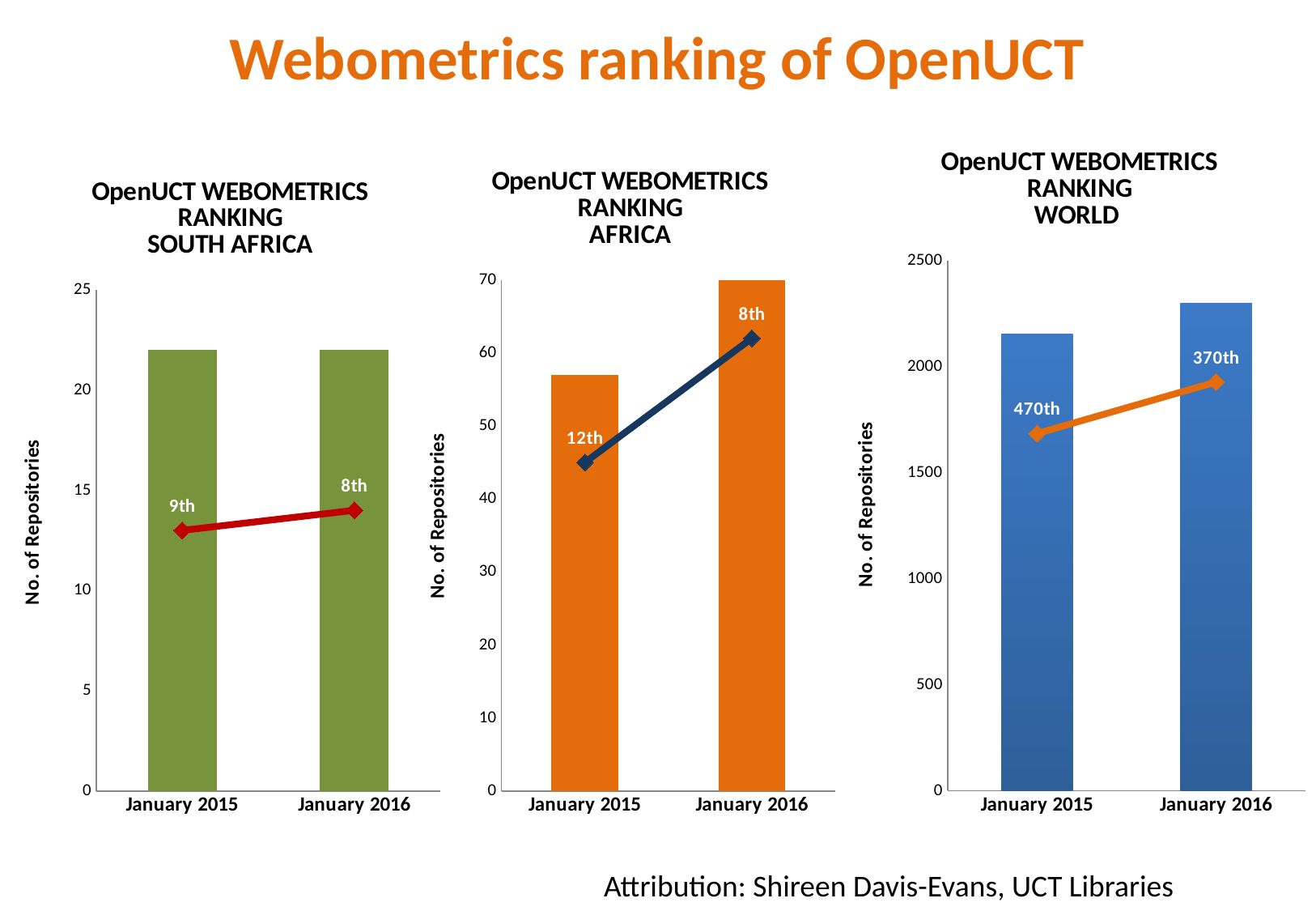
On the OpenUCT Webometrics Ranking Africa chart, what rank label is shown for January 2016? 8th On the OpenUCT Webometrics Ranking Africa chart, what rank label is shown for January 2015? 12th What is the y-axis title on the OpenUCT Webometrics Ranking World chart? No. of Repositories On the OpenUCT Webometrics Ranking South Africa chart, what rank label is shown for January 2016? 8th On the OpenUCT Webometrics Ranking World chart, is the number of repositories for January 2016 greater or less than 2000? greater On the OpenUCT Webometrics Ranking World chart, what rank label is shown for January 2015? 470th On the OpenUCT Webometrics Ranking Africa chart, which category has the highest number of repositories? January 2016 How many categories are shown on the x axis of the OpenUCT Webometrics Ranking South Africa chart? 2 On the OpenUCT Webometrics Ranking Africa chart, is the number of repositories for January 2015 greater or less than 50? greater On the OpenUCT Webometrics Ranking South Africa chart, what rank label is shown for January 2015? 9th On the OpenUCT Webometrics Ranking World chart, what rank label is shown for January 2016? 370th On the OpenUCT Webometrics Ranking World chart, which category has the taller bar, January 2015 or January 2016? January 2016